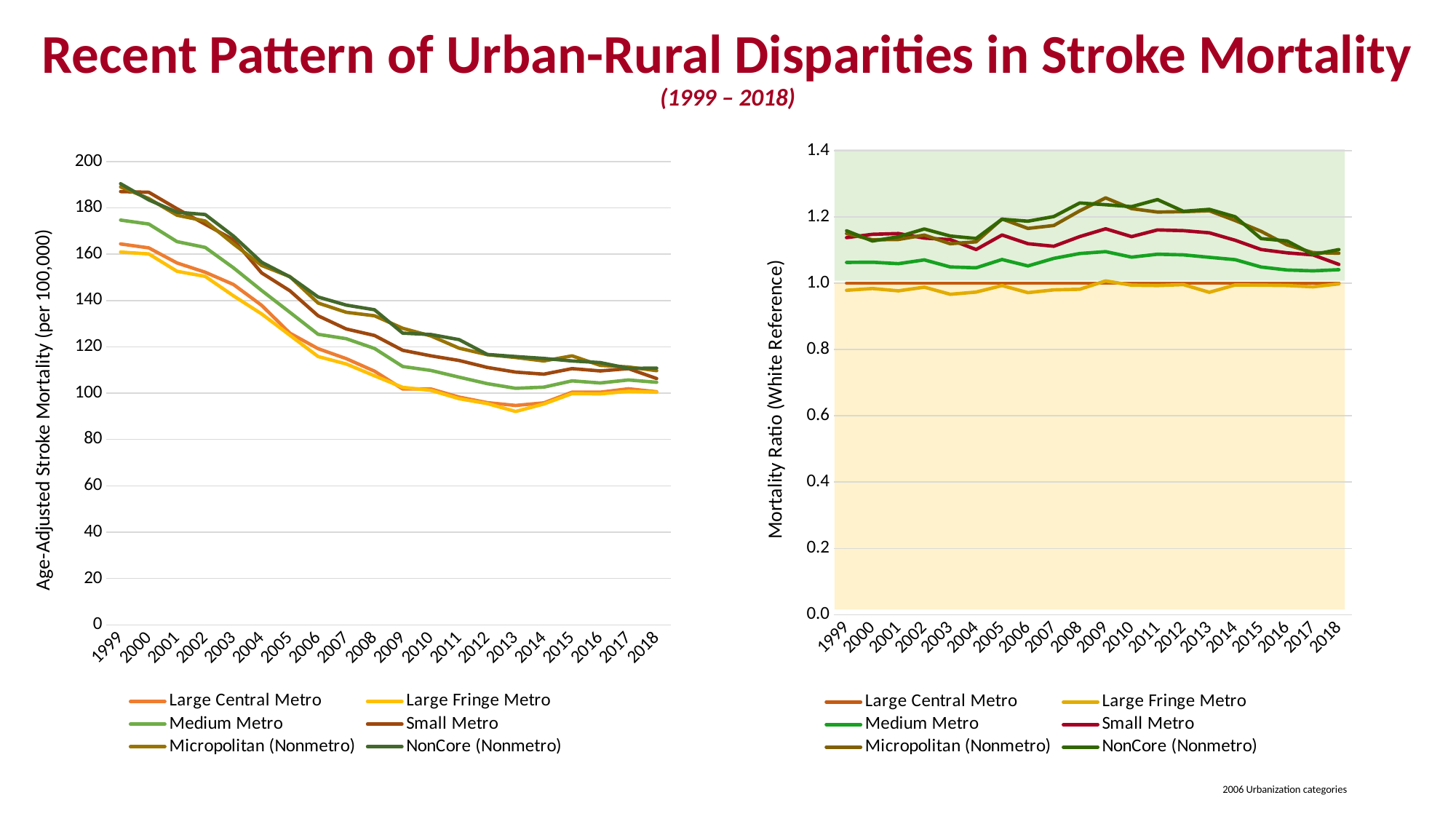
What is the y-axis label of the left chart? Age-Adjusted Stroke Mortality (per 100,000) How many series does the legend of the right chart (Mortality Ratio) list? 6 In the left chart (Age-Adjusted Stroke Mortality), is the value for Large Fringe Metro in 2013 greater or less than 100? less In the right chart (Mortality Ratio), is the value for Medium Metro in 2018 greater or less than 1.2? less How many years are shown on the x axis of the left chart (Age-Adjusted Stroke Mortality)? 20 In the right chart (Mortality Ratio), is the value for NonCore (Nonmetro) in 2009 greater or less than 1.2? greater In the left chart (Age-Adjusted Stroke Mortality), which series has the lowest value in 1999? Large Fringe Metro In the left chart (Age-Adjusted Stroke Mortality), which series has the highest value in 1999? NonCore (Nonmetro) In the left chart (Age-Adjusted Stroke Mortality), do the values for Large Central Metro rise or fall from 1999 to 2018? fall What kind of chart is the left chart (Age-Adjusted Stroke Mortality)? line chart